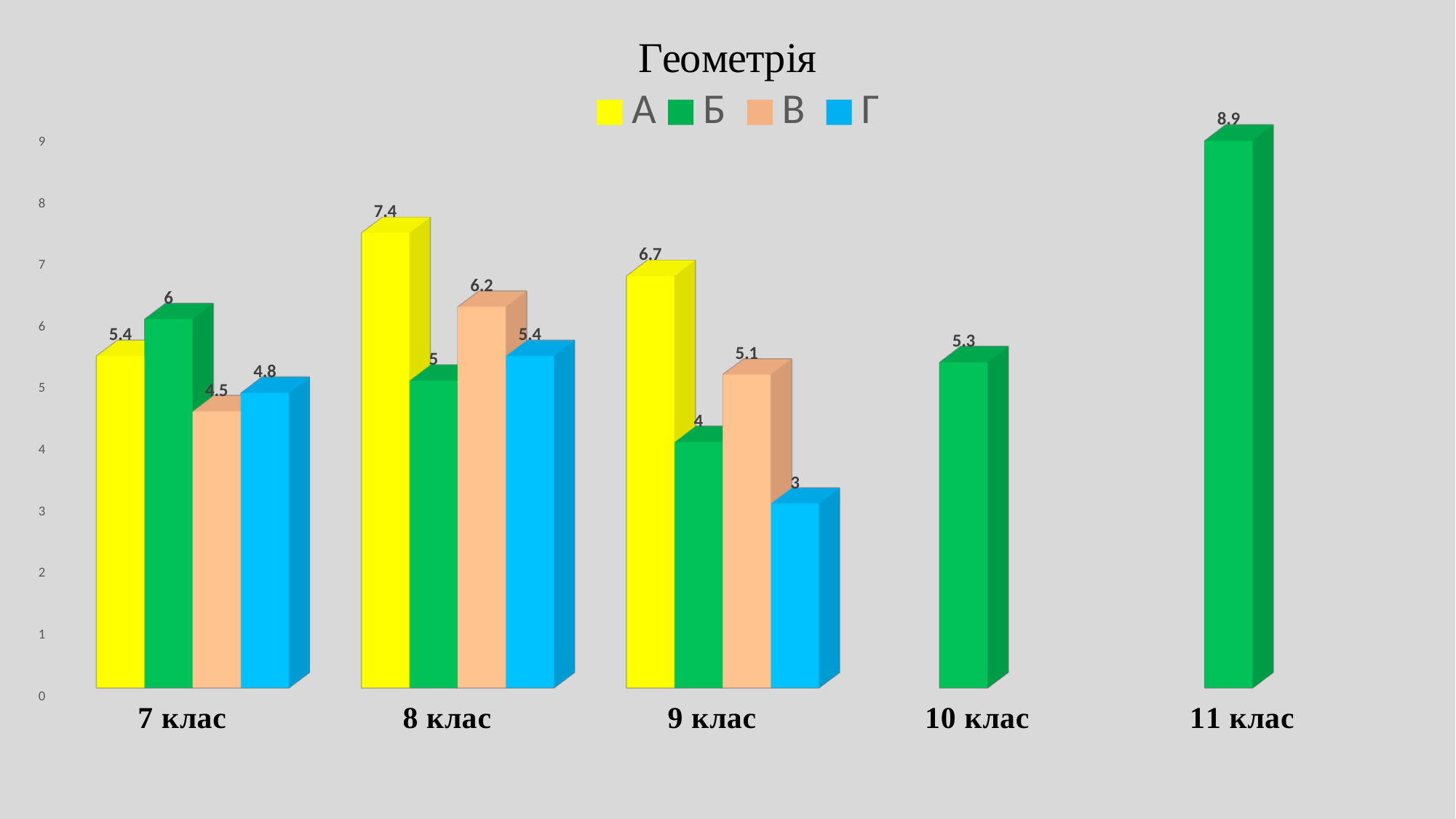
What is the title of the chart? Геометрія Which is larger in 7 клас: series А or series Б? Б What is the value for series А in 8 клас? 7.4 What is the difference between series А and series Б in 8 клас? 2.4 How many categories are shown on the x axis? 5 What kind of chart is shown on the slide? Bar chart How many series does the legend list? 4 What is the value for series В in 7 клас? 4.5 Which category has the highest value for series Б? 11 клас What is the value for series Г in 9 клас? 3 Which series has the lowest value in 9 клас? Г What is the value for series Б in 11 клас? 8.9